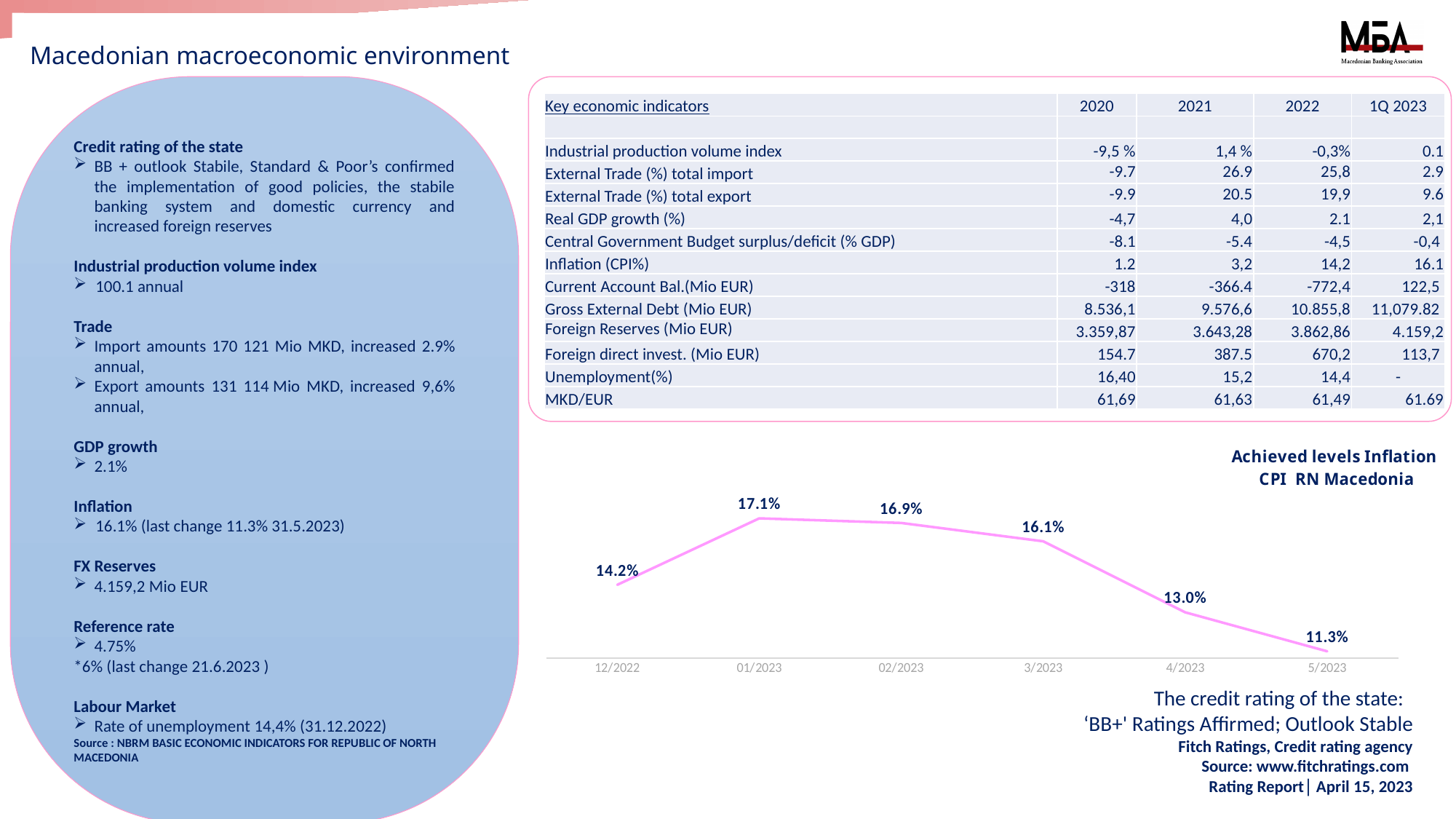
What is the inflation value for 01/2023 in the chart? 17.1% How many data points are plotted in the chart? 6 What kind of chart is shown on the slide? line chart Which month has the highest inflation value in the chart? 01/2023 What is the inflation value for 12/2022 in the chart? 14.2% What is the inflation value for 5/2023 in the chart? 11.3% What is the inflation value for 4/2023 in the chart? 13.0% What is the title of the chart? Achieved levels Inflation CPI RN Macedonia What is the difference between the inflation values for 3/2023 and 4/2023? 3.1% Which is larger, the inflation value for 02/2023 or for 3/2023? 02/2023 What is the difference between the inflation values for 01/2023 and 5/2023? 5.8% Which month has the lowest inflation value in the chart? 5/2023